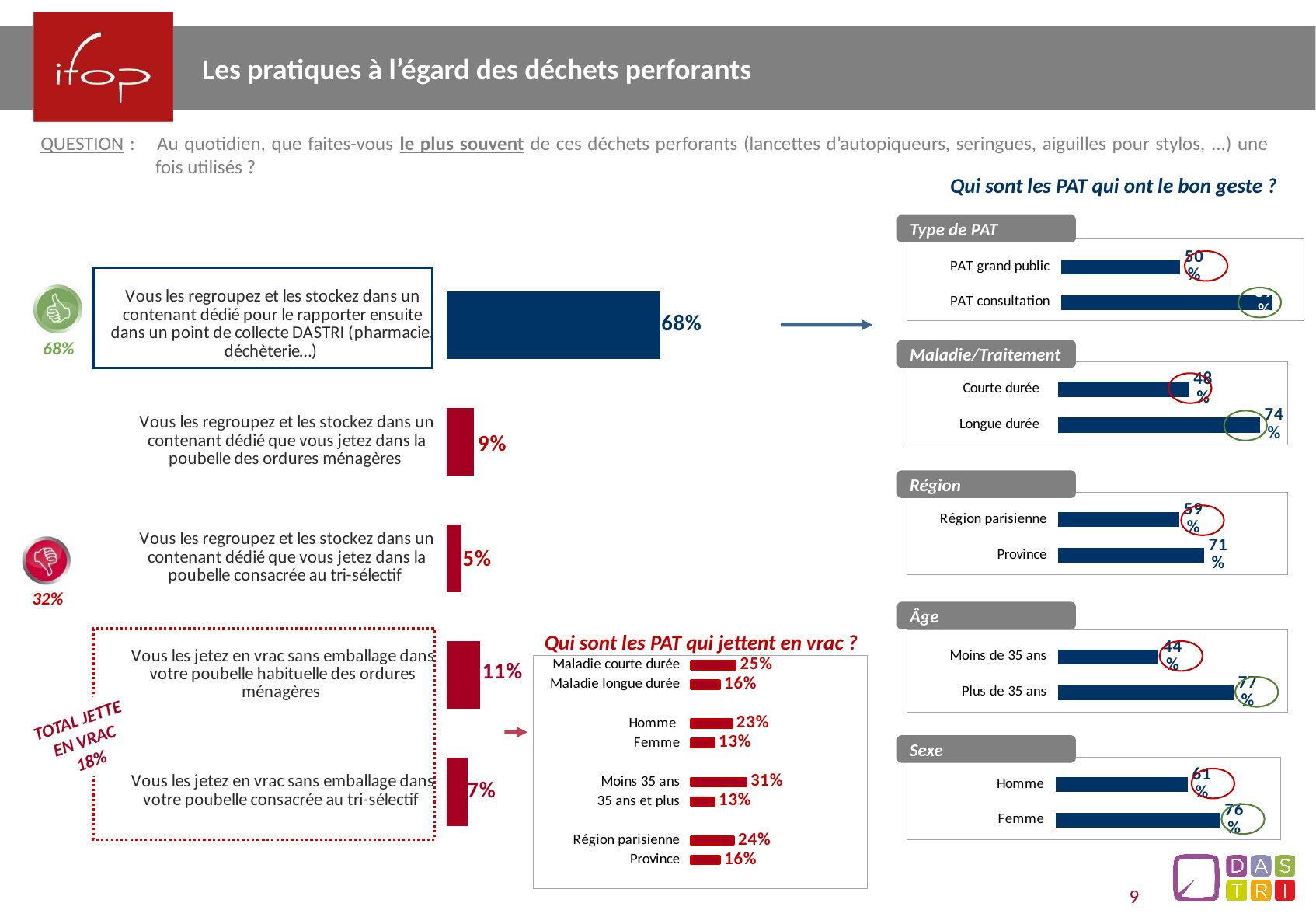
In the chart 'Qui sont les PAT qui jettent en vrac ?', what is the value for 'Moins 35 ans'? 31% In the main bar chart on the left, what is the value for 'Vous les regroupez et les stockez dans un contenant dédié pour le rapporter ensuite dans un point de collecte DASTRI'? 68% In the main bar chart on the left, which category has the lowest value? Vous les regroupez et les stockez dans un contenant dédié que vous jetez dans la poubelle consacrée au tri-sélectif In the main bar chart on the left, how many categories are shown? 5 In the 'Maladie/Traitement' chart on the right, what is the value for 'Longue durée'? 74% In the 'Âge' chart on the right, what is the value for 'Moins de 35 ans'? 44% In the main bar chart on the left, what is the value for 'Vous les jetez en vrac sans emballage dans votre poubelle habituelle des ordures ménagères'? 11% What kind of chart is the main chart on the left of the slide? Bar chart In the 'Sexe' chart on the right, which is larger, Homme or Femme? Femme In the chart 'Qui sont les PAT qui jettent en vrac ?', which is larger, Homme or Femme? Homme In the main bar chart on the left, what is the difference between the 9% category and the 5% category? 4% In the chart 'Qui sont les PAT qui jettent en vrac ?', what is the difference between 'Maladie courte durée' and 'Maladie longue durée'? 9%